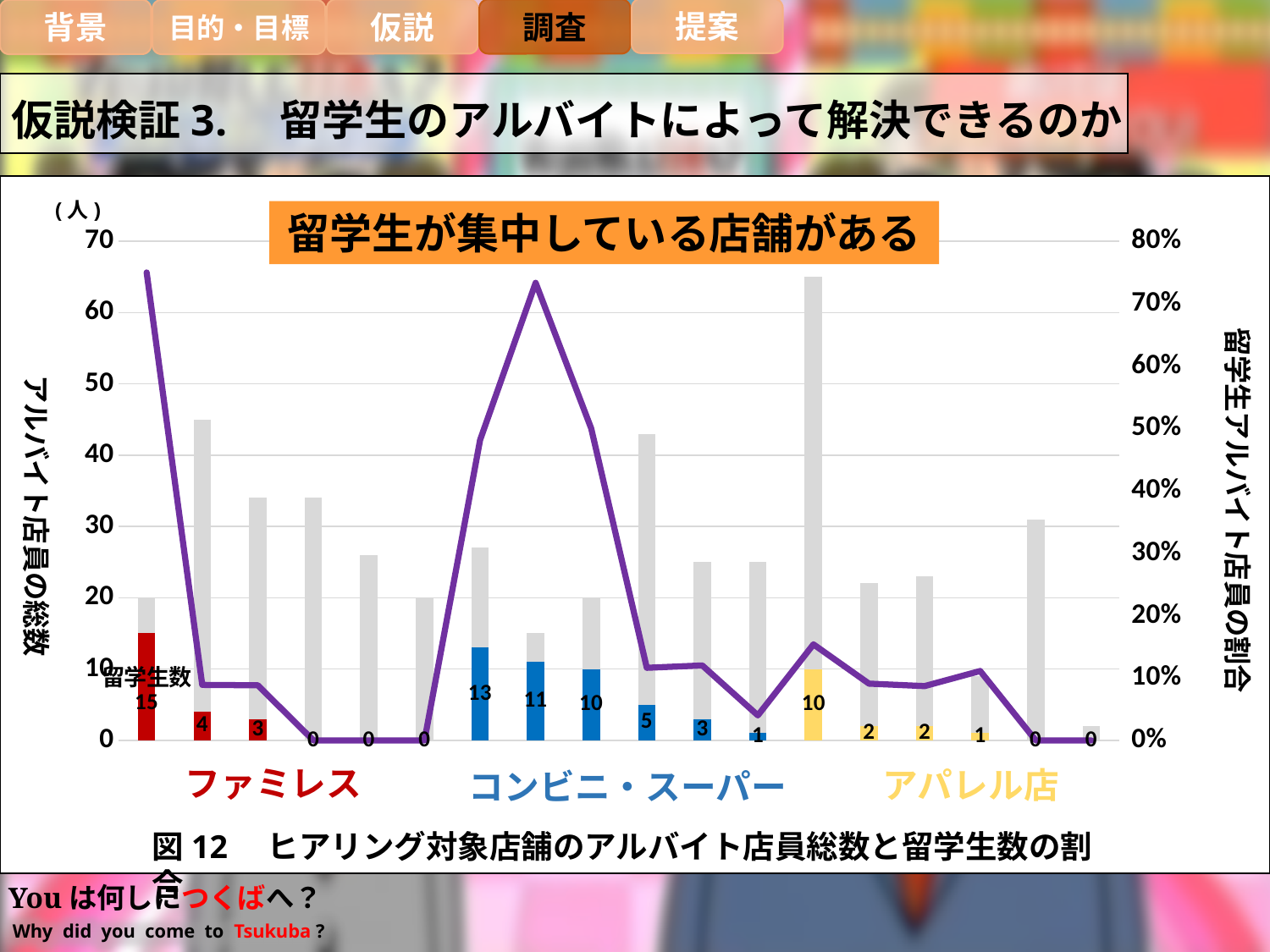
Is the total number of part-time staff (gray bar) for the tallest bar in the コンビニ・スーパー group greater or less than 60? less What is the labelled number of international student staff for the first store in the コンビニ・スーパー group? 13 What kind of chart is shown on the slide? A combined bar and line chart Is the share of international student staff (purple line) for the first store in the ファミレス group greater or less than 70%? greater What is the maximum value shown on the right-hand percentage axis? 80% What is the labelled number of international student staff for the first store in the アパレル店 group? 10 What is the highest labelled number of international student staff (留学生数) among all stores? 15 What is the difference between the highest labelled international student count in the ファミレス group (15) and the highest in the コンビニ・スーパー group (13)? 2 Which is larger: the international student count of the first store in the コンビニ・スーパー group or the second store in that group? The first store (13) How many store groups are labelled below the x axis? 3 How many stores (bars) are plotted along the x axis? 18 What is the label of the left vertical axis? アルバイト店員の総数